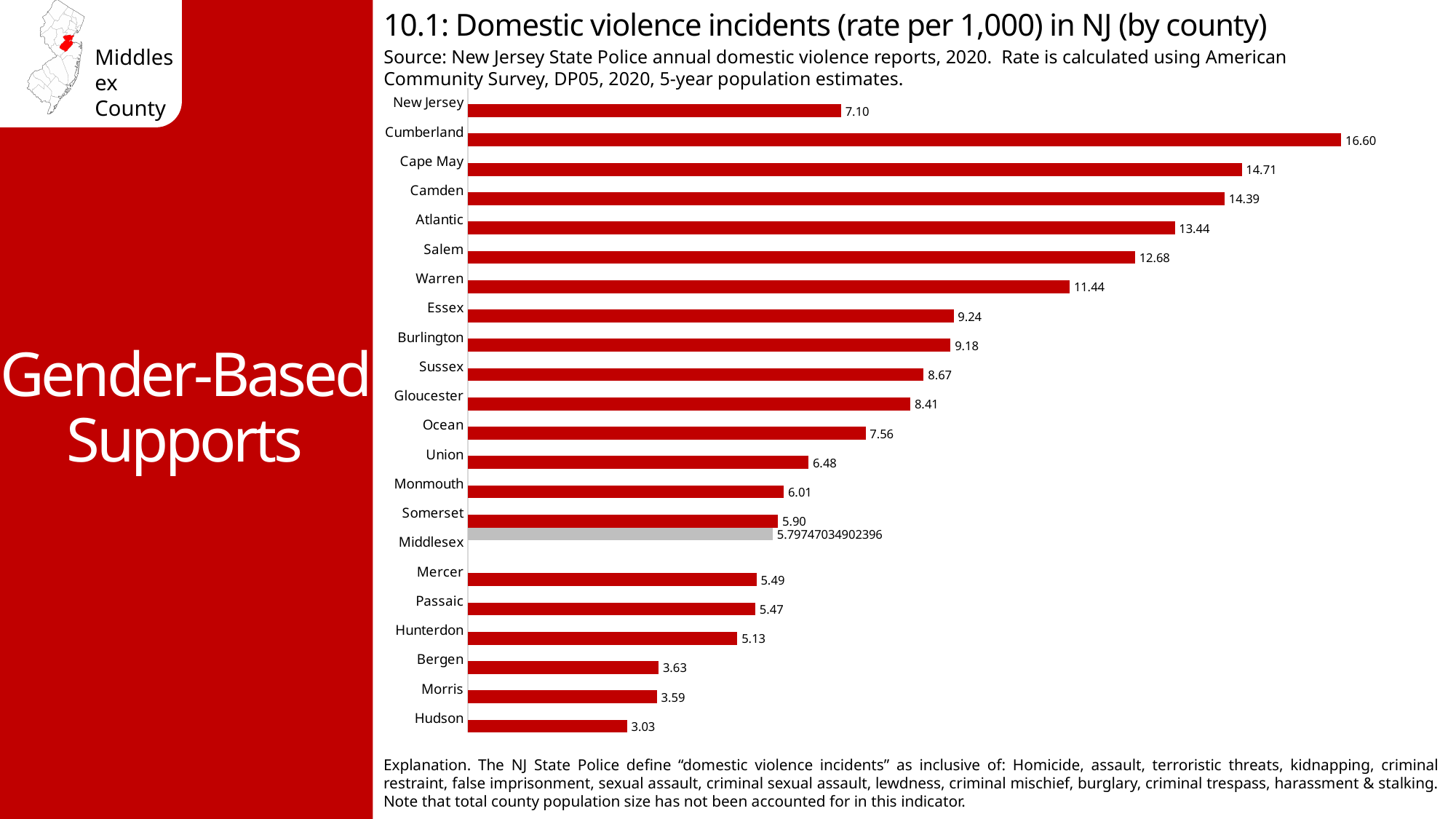
What is the difference between the rates for Cumberland and Hudson? 13.57 What is the difference between the rates for Ocean and New Jersey? 0.46 What type of chart is used on this slide? Bar chart Which bar is shown in a different colour (grey) from the others? Middlesex Which has a higher rate, Warren or Salem? Salem How many bars (categories) are shown in the chart? 22 What is the domestic violence incident rate per 1,000 for Cumberland? 16.60 What is the domestic violence incident rate per 1,000 shown for New Jersey overall? 7.10 Which county has the highest domestic violence incident rate? Cumberland What value is labeled on the Middlesex bar? 5.79747034902396 Which has a higher rate, Essex or Burlington? Essex Which county has the lowest domestic violence incident rate? Hudson